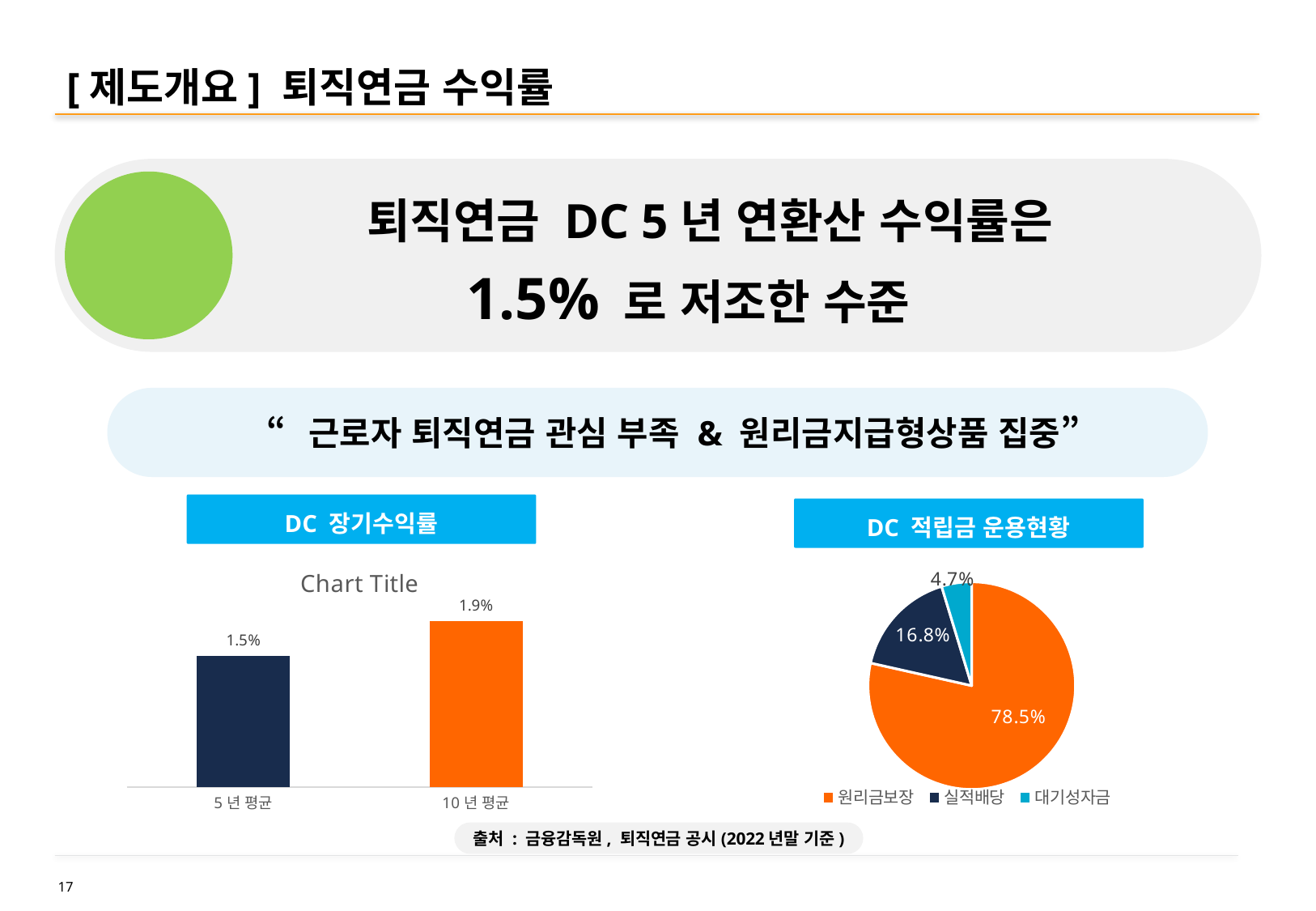
In the DC 장기수익률 bar chart, what is the difference between the 10 년 평균 and 5 년 평균 values? 0.4% In the DC 적립금 운용현황 pie chart, what colour is the 원리금보장 slice? Orange In the DC 장기수익률 bar chart, what is the value for 5 년 평균? 1.5% In the DC 적립금 운용현황 pie chart, what share does 원리금보장 have? 78.5% In the DC 장기수익률 bar chart, which category has the higher value? 10 년 평균 In the DC 장기수익률 bar chart, what is the value for 10 년 평균? 1.9% In the DC 장기수익률 bar chart, how many bars are plotted? 2 In the DC 적립금 운용현황 pie chart, how many slices are there? 3 In the DC 적립금 운용현황 pie chart, what share does 실적배당 have? 16.8% In the DC 적립금 운용현황 pie chart, what share does 대기성자금 have? 4.7% In the DC 적립금 운용현황 pie chart, which slice is the smallest? 대기성자금 What kind of chart is shown under DC 장기수익률? Bar chart